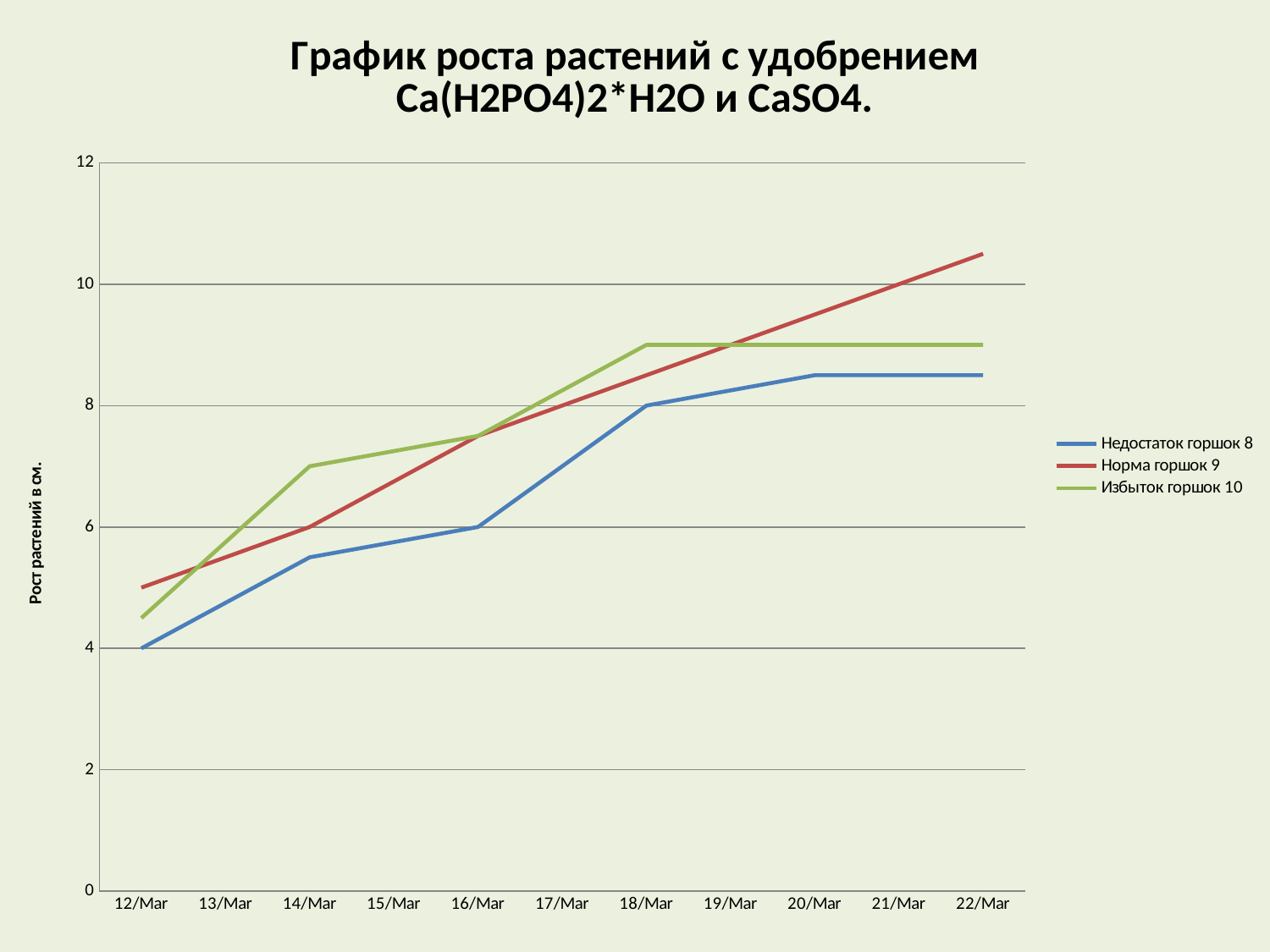
On 14/Mar, which is larger: Избыток горшок 10 or Норма горшок 9? Избыток горшок 10 Is the value for Норма горшок 9 on 22/Mar greater or less than 10? greater What is the value for Недостаток горшок 8 on 18/Mar? 8 What is the value for Норма горшок 9 on 14/Mar? 6 Does the Норма горшок 9 line rise or fall from 12/Mar to 22/Mar? rise Which series has the lowest value on 12/Mar? Недостаток горшок 8 Which series has the highest value on 22/Mar? Норма горшок 9 What is the label of the y axis? Рост растений в см. What kind of chart is shown on the slide? line chart How many series does the legend list? 3 How many date labels are shown along the x axis? 11 What is the value for Недостаток горшок 8 on 12/Mar? 4